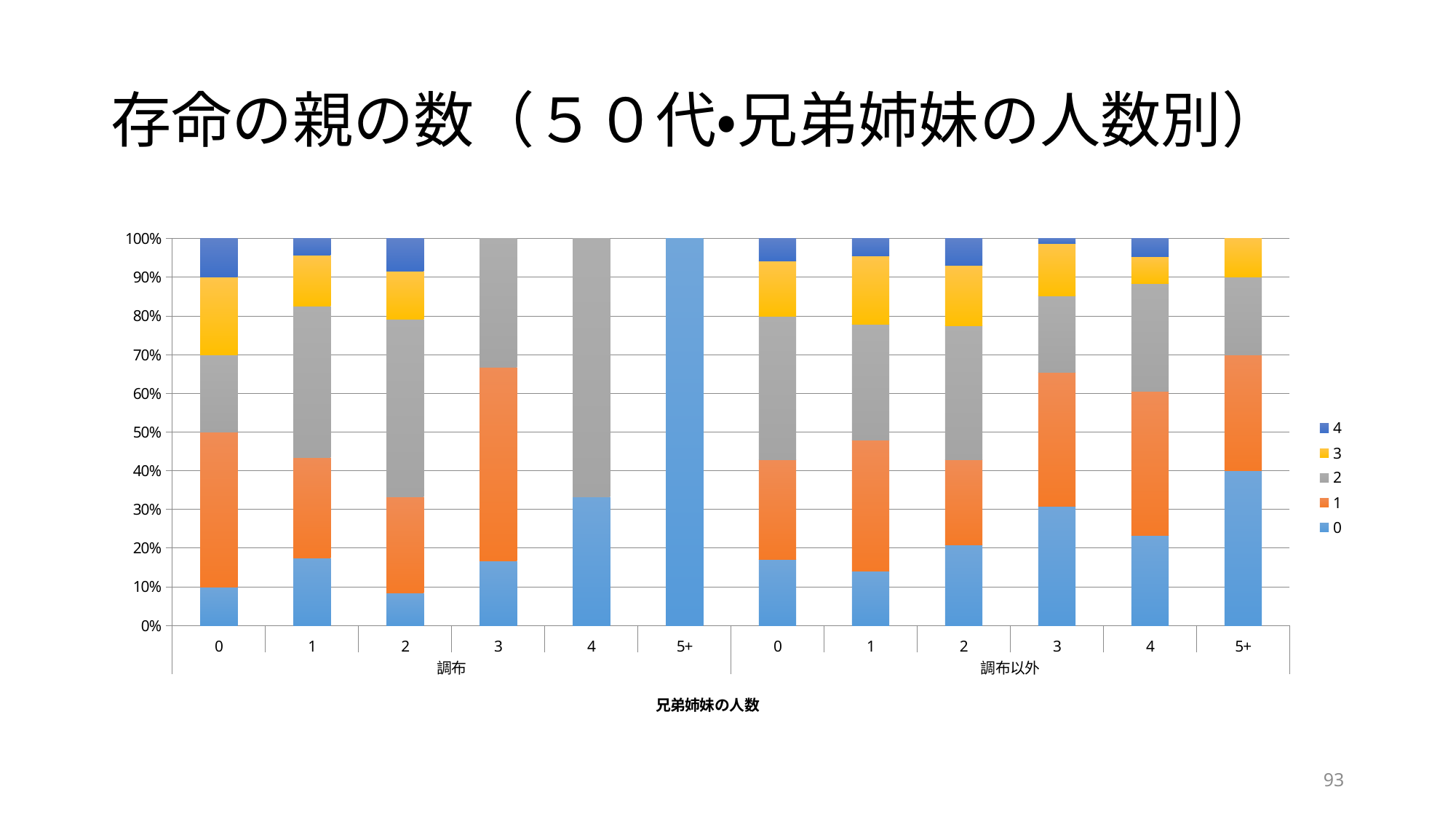
What kind of chart is shown on the slide? stacked bar chart What is the title of the chart's x axis? 兄弟姉妹の人数 Is the value of series 0 for the 1 category in the 調布 group greater or less than 10%? greater Is the value of series 0 for the 1 category in the 調布以外 group greater or less than 10%? greater Is the value of series 0 for the 4 category in the 調布 group greater or less than 30%? greater Which is larger: the series 0 share for 5+ in the 調布以外 group or for 0 in the 調布 group? 5+ in 調布以外 How many bars are plotted in the chart? 12 Which bar has the largest share for series 0? 調布 5+ What is the title of the slide? 存命の親の数（５０代•兄弟姉妹の人数別） What is the value of series 0 for the 5+ category in the 調布 group? 100% How many series does the legend list? 5